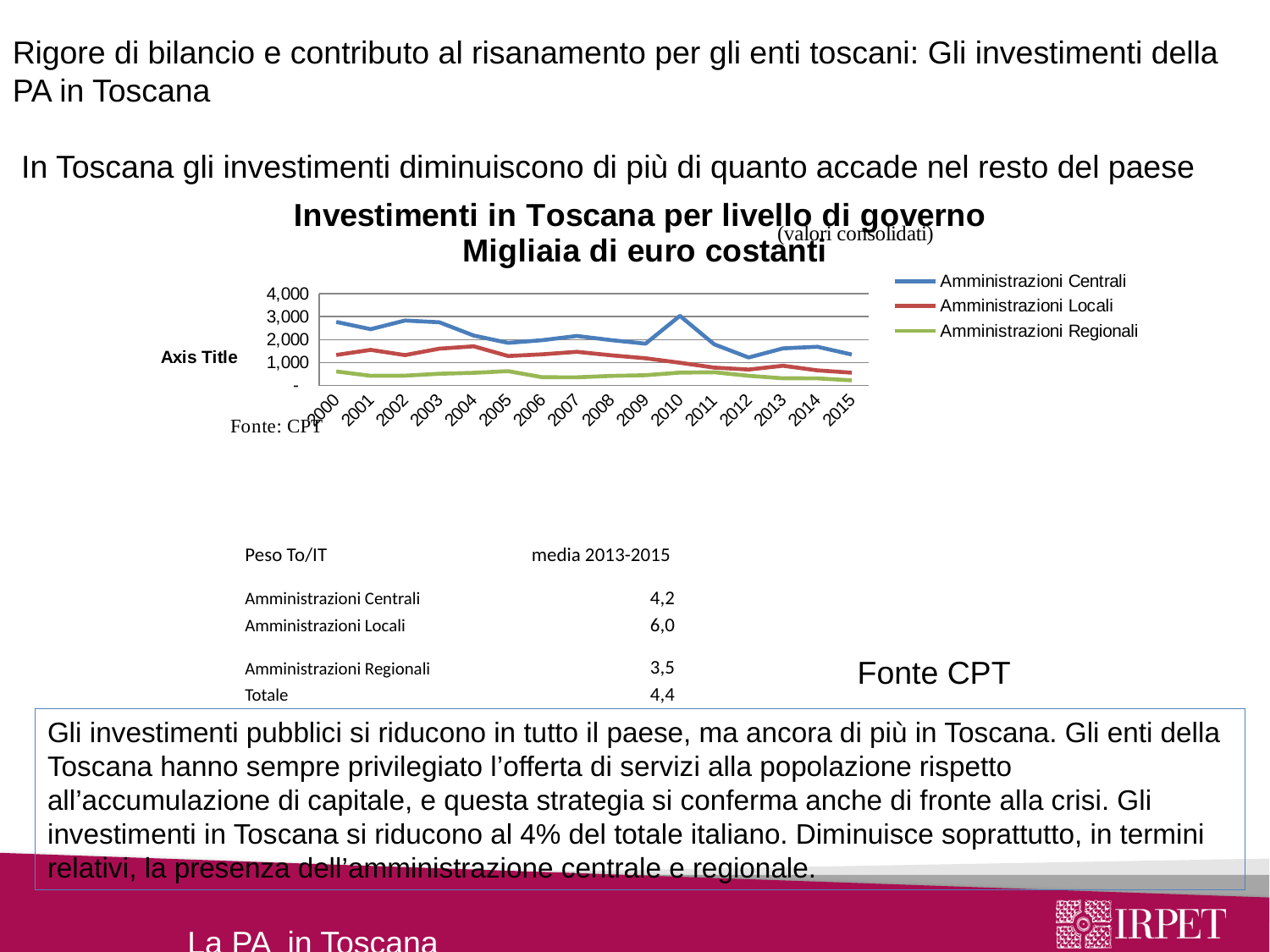
Which colour is used for the Amministrazioni Regionali series in the chart? green How many years are plotted along the x axis of the chart? 16 Overall, does the Amministrazioni Centrali line rise or fall from 2000 to 2015? fall Which series has the highest value in 2000? Amministrazioni Centrali Is the value for Amministrazioni Centrali in 2015 greater or less than 2,000? less How many series does the chart legend list? 3 Which series has the lowest value in 2015? Amministrazioni Regionali Is the value for Amministrazioni Centrali in 2010 greater or less than 2,000? greater In 2008, which is larger: the value for Amministrazioni Centrali or for Amministrazioni Regionali? Amministrazioni Centrali What kind of chart is shown on the slide? line chart Is the value for Amministrazioni Regionali in 2005 greater or less than 1,000? less